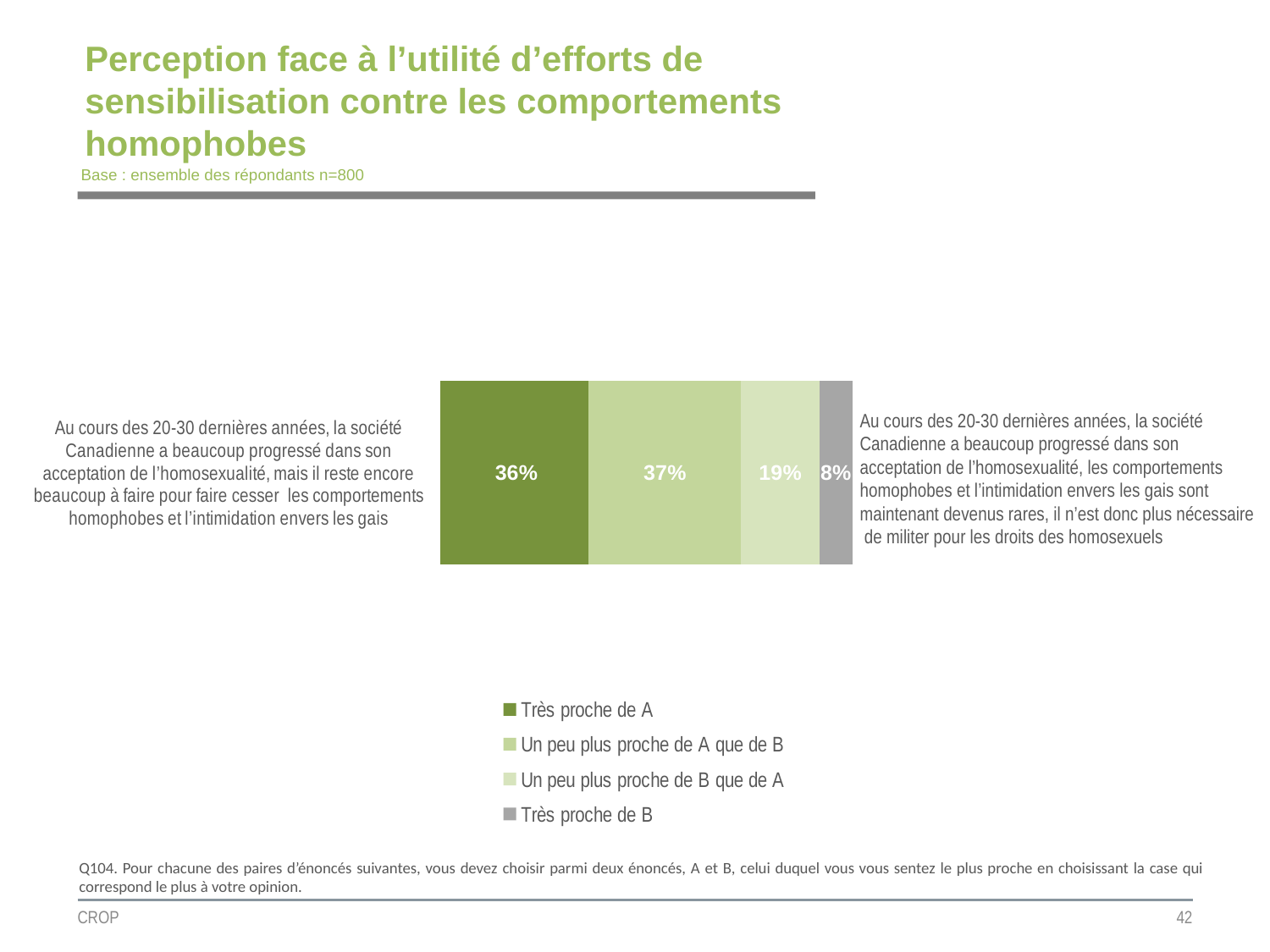
Which response category has the smallest share? Très proche de B What is the base (number of respondents) stated on the slide? n=800 What percentage of respondents answered "Un peu plus proche de B que de A"? 19% What is the difference between the share for "Un peu plus proche de A que de B" and the share for "Un peu plus proche de B que de A"? 18% What percentage of respondents answered "Très proche de A"? 36% What kind of chart is shown on the slide? Stacked bar chart Which response category has the largest share? Un peu plus proche de A que de B What is the combined share of respondents who are closer to statement A ("Très proche de A" plus "Un peu plus proche de A que de B")? 73% How many response categories does the legend list? 4 What percentage of respondents answered "Un peu plus proche de A que de B"? 37% Which is larger: the share for "Très proche de A" or the share for "Très proche de B"? Très proche de A What percentage of respondents answered "Très proche de B"? 8%